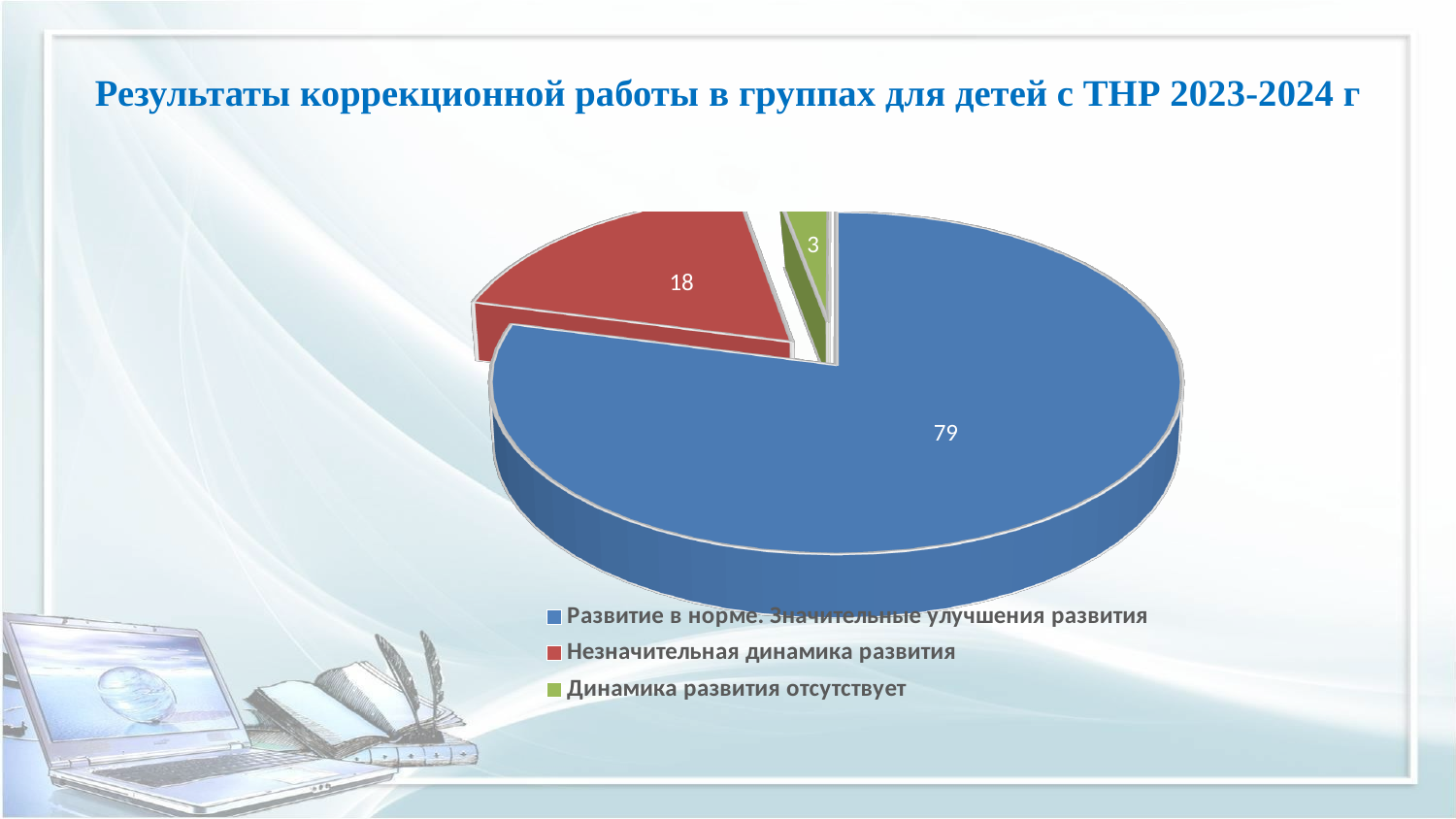
What is the difference between the values for "Незначительная динамика развития" and "Динамика развития отсутствует"? 15 What share of the pie does "Незначительная динамика развития" represent? 18% What colour is the slice for "Динамика развития отсутствует"? Green What is the difference between the values for "Развитие в норме. Значительные улучшения развития" and "Незначительная динамика развития"? 61 What is the value for "Динамика развития отсутствует"? 3 What is the value for "Развитие в норме. Значительные улучшения развития"? 79 Which category has the largest slice of the pie? Развитие в норме. Значительные улучшения развития Which is larger: the value for "Незначительная динамика развития" or for "Динамика развития отсутствует"? Незначительная динамика развития What is the value for "Незначительная динамика развития"? 18 How many categories does the pie chart have? 3 Which category has the smallest slice of the pie? Динамика развития отсутствует What type of chart is shown on the slide? Pie chart